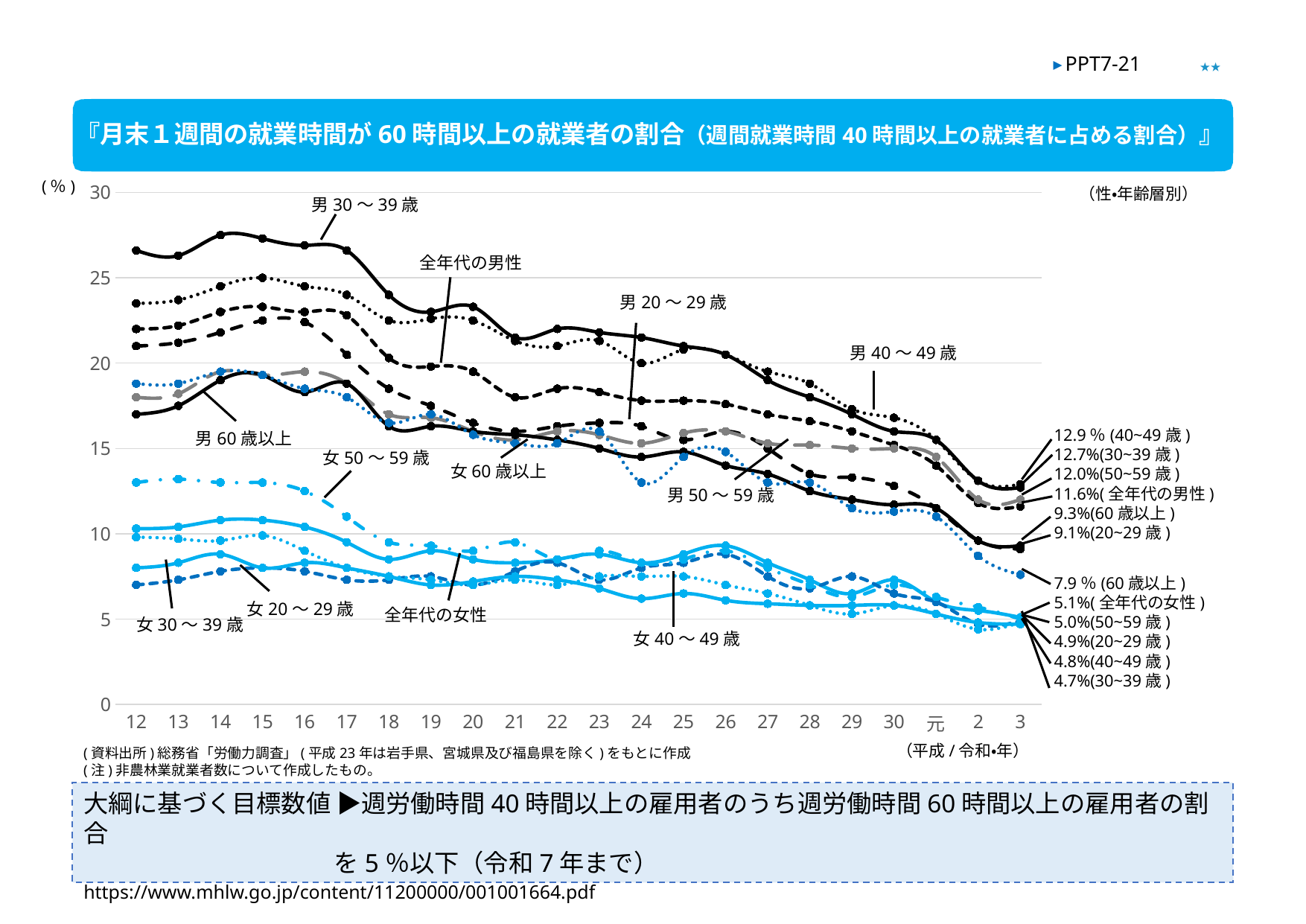
男30～39歳の値は平成12年から令和3年にかけて全体として上昇していますか、下降していますか？ 下降 令和3年の全年代の女性の値はいくつですか？ 5.1% 平成12年の男30～39歳の値は25より大きいですか、小さいですか？ 大きい 令和3年の男性60歳以上と男性20～29歳では、どちらの値が大きいですか？ 男性60歳以上（9.3%） 令和3年の全年代の男性と全年代の女性の値の差はいくつですか？ 6.5ポイント 令和3年の全年代の男性の値はいくつですか？ 11.6% このグラフはどの種類のグラフですか？ 折れ線グラフ 令和3年時点で最も値が高い系列はどれですか？ 男40～49歳（12.9％） 横軸には何年分のデータ点がありますか？ 22 令和3年時点で最も値が低い系列はどれですか？ 女30～39歳（4.7%） 令和3年の男性40～49歳の値はいくつですか？ 12.9％ 令和3年の女性60歳以上の値はいくつですか？ 7.9％